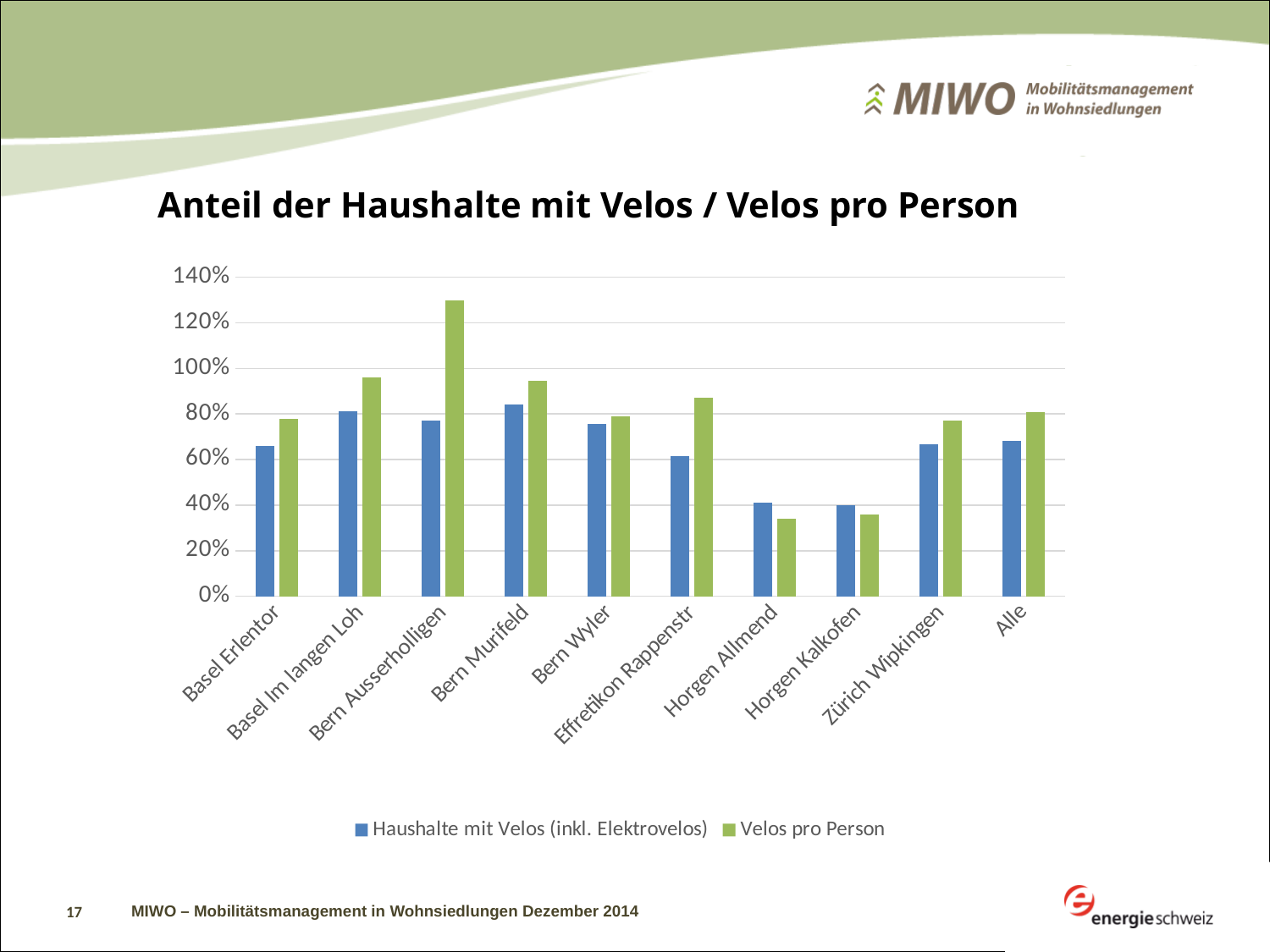
What is the title of the chart? Anteil der Haushalte mit Velos / Velos pro Person Is the Velos pro Person value for Horgen Kalkofen greater or less than 60%? less For Horgen Allmend, which series has the larger value: Haushalte mit Velos (inkl. Elektrovelos) or Velos pro Person? Haushalte mit Velos (inkl. Elektrovelos) Is the Velos pro Person value for Bern Ausserholligen greater or less than 120%? greater For Basel Im langen Loh, which series has the larger value: Haushalte mit Velos (inkl. Elektrovelos) or Velos pro Person? Velos pro Person How many categories are shown on the x axis? 10 Is the Velos pro Person value for Effretikon Rappenstr greater or less than 80%? greater What kind of chart is shown on the slide? bar chart Which category has the highest value for Velos pro Person? Bern Ausserholligen How many series does the legend list? 2